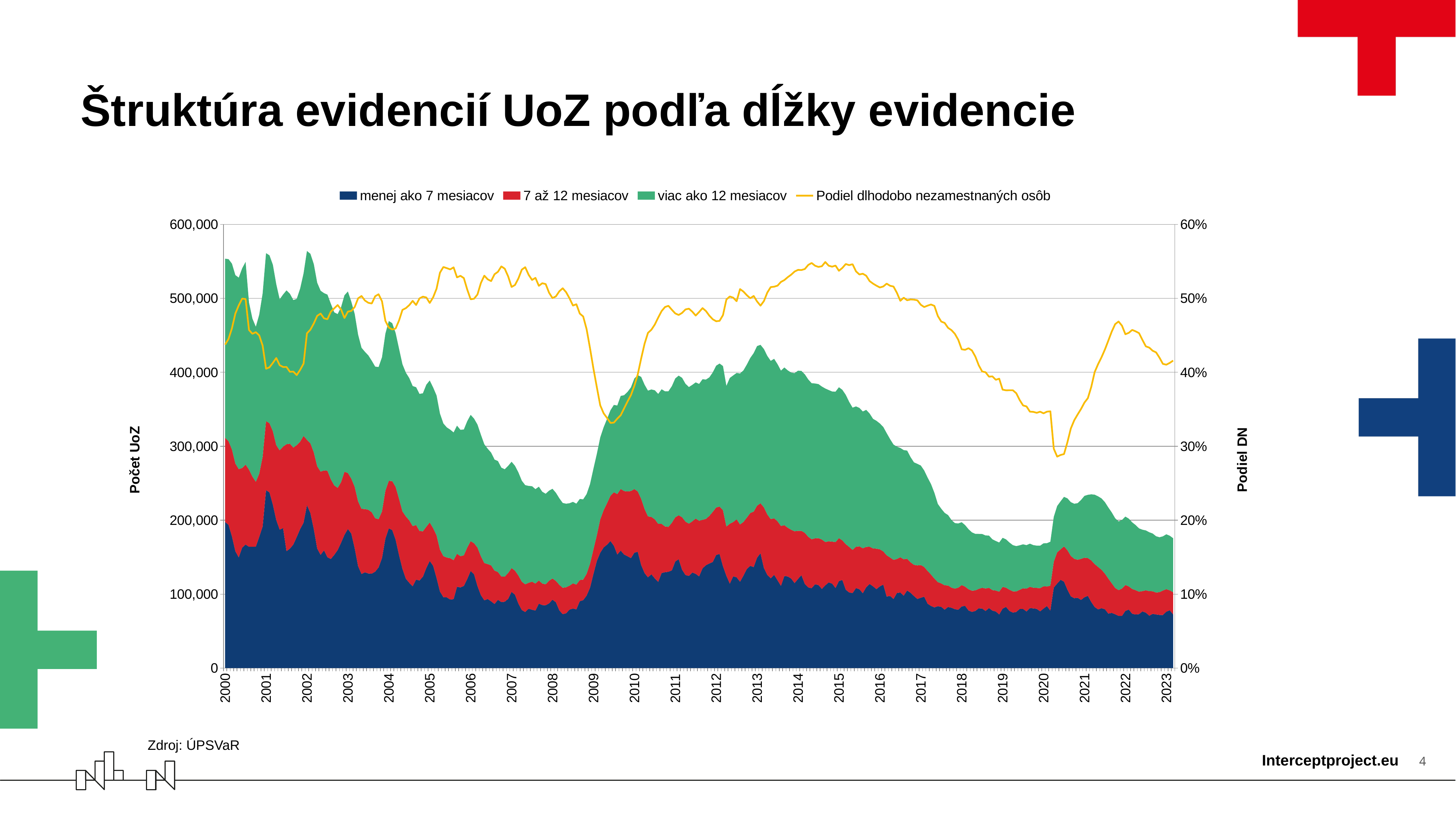
In which year does the 'Podiel dlhodobo nezamestnaných osôb' line reach its lowest point? 2020 Is the total stacked value larger in 2013 or in 2023? 2013 How many year labels are shown on the x axis? 24 Is the 'Podiel dlhodobo nezamestnaných osôb' line around 2015 greater or less than 50%? greater Does the total stacked value overall rise or fall from 2000 to 2023? fall Which series is drawn as the yellow line? Podiel dlhodobo nezamestnaných osôb Is the total stacked value at 2023 greater or less than 200,000? less What is the title of the right-hand vertical axis? Podiel DN Is the total stacked value at the start of 2000 greater or less than 500,000? greater How many series does the legend list? 4 What kind of chart is shown on the slide? stacked area chart with a line